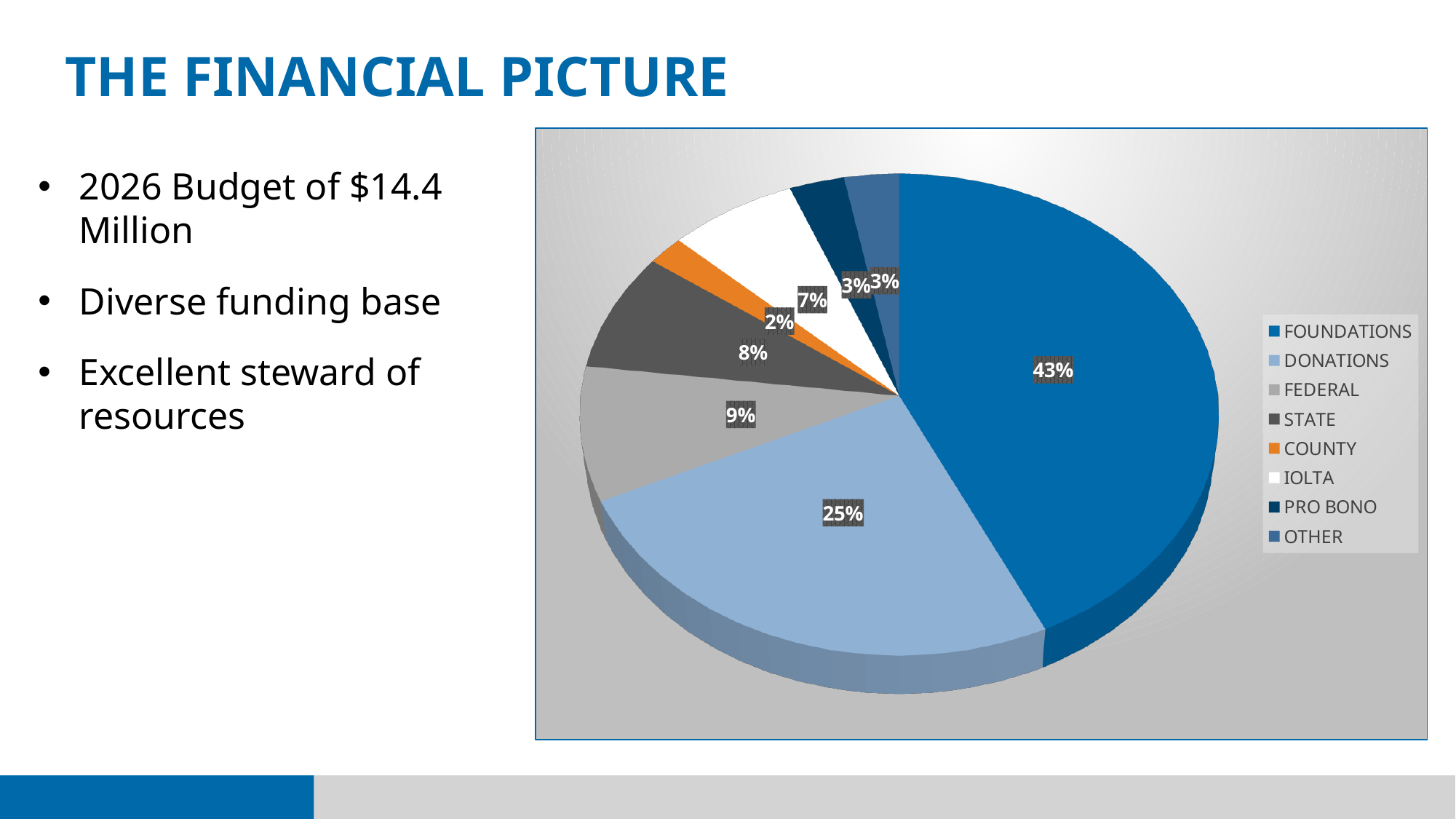
What is the difference between the FOUNDATIONS share and the DONATIONS share? 18% What share of the pie does DONATIONS represent? 25% What is the value shown for FEDERAL? 9% What kind of chart is shown on the slide? Pie chart Which category has the smallest slice of the pie? COUNTY What is the value shown for COUNTY? 2% How many categories does the legend list? 8 Which is larger, the STATE share or the IOLTA share? STATE What is the value shown for IOLTA? 7% What colour is the COUNTY slice in the pie chart? Orange What share of the pie does FOUNDATIONS represent? 43% Which category has the largest slice of the pie? FOUNDATIONS